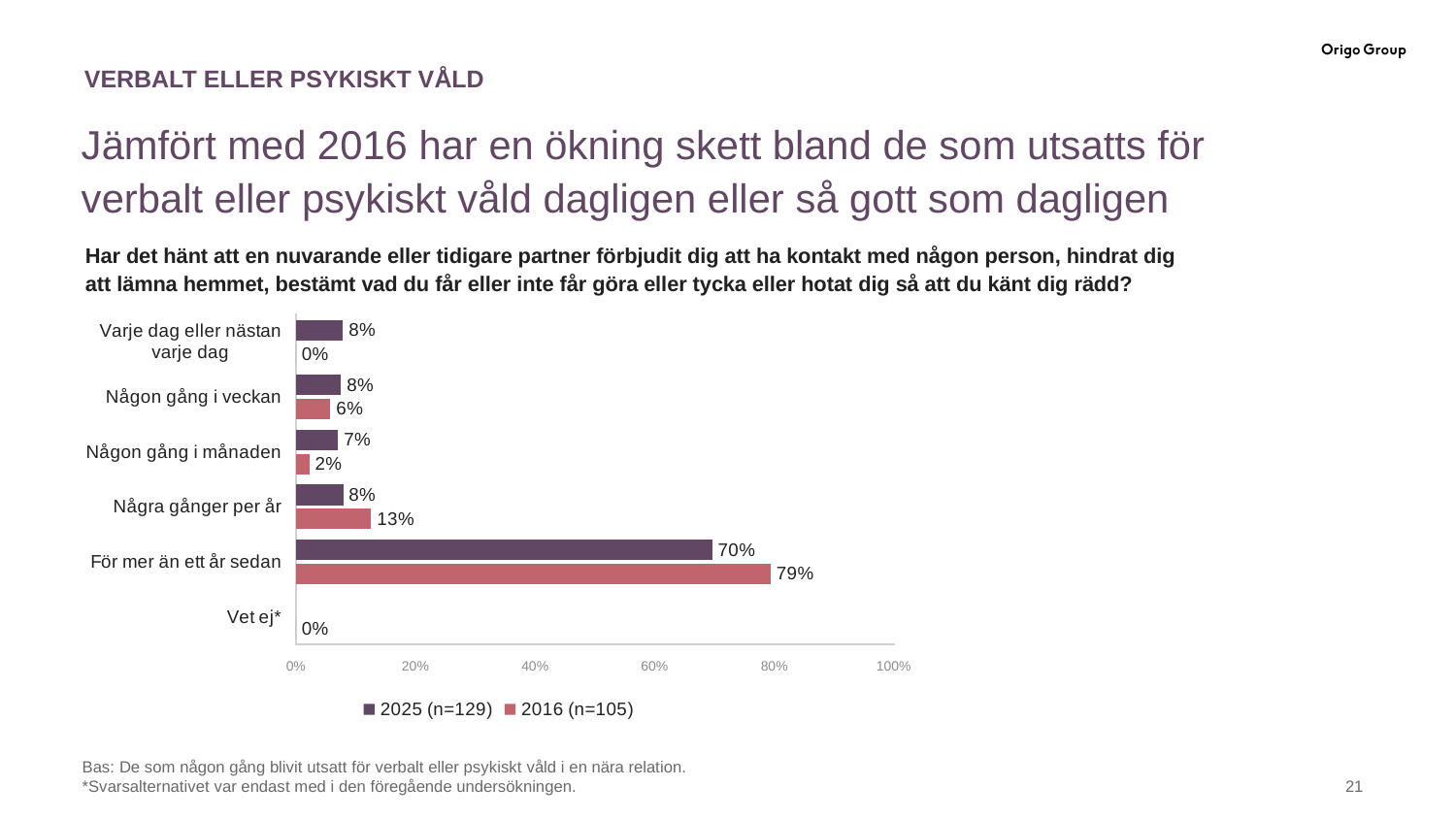
How many series does the legend list? 2 What is the value for 'Varje dag eller nästan varje dag' in the 2025 (n=129) series? 8% What kind of chart is shown on the slide? bar chart What is the value for 'Någon gång i månaden' in the 2016 (n=105) series? 2% How many categories are shown on the y axis of the chart? 6 For 'Några gånger per år', which series has the larger value, 2025 (n=129) or 2016 (n=105)? 2016 (n=105) Which category has the highest value in the 2025 (n=129) series? För mer än ett år sedan What is the value for 'För mer än ett år sedan' in the 2025 (n=129) series? 70% What is the difference between the 2025 (n=129) and 2016 (n=105) values for 'Någon gång i månaden'? 5% What is the value for 'För mer än ett år sedan' in the 2016 (n=105) series? 79% What is the value for 'Några gånger per år' in the 2016 (n=105) series? 13% What is the difference between the 2016 (n=105) and 2025 (n=129) values for 'För mer än ett år sedan'? 9%